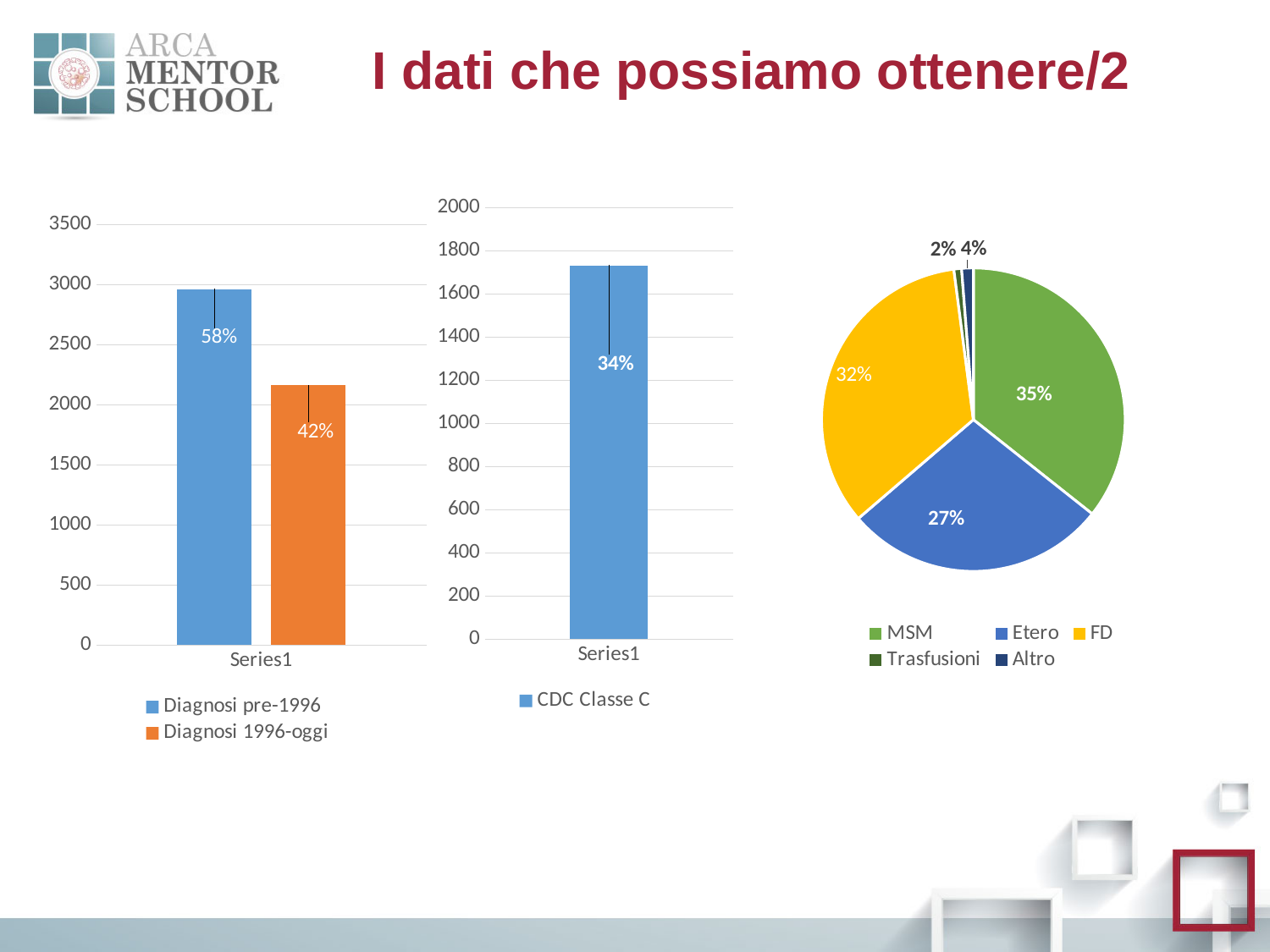
On the middle bar chart, is the value for CDC Classe C greater or less than 1600? greater On the left bar chart, what is the data label on the Diagnosi 1996-oggi bar? 42% On the pie chart, what share does the MSM slice have? 35% How many series does the legend of the left bar chart list? 2 What kind of chart is the chart on the right of the slide? Pie chart On the pie chart, which category has the largest slice? MSM On the left bar chart, is the value for Diagnosi 1996-oggi greater or less than 2000? greater On the middle bar chart, what is the data label on the CDC Classe C bar? 34% On the left bar chart, what is the data label on the Diagnosi pre-1996 bar? 58% On the left bar chart, which series has the taller bar? Diagnosi pre-1996 How many categories does the legend of the pie chart list? 5